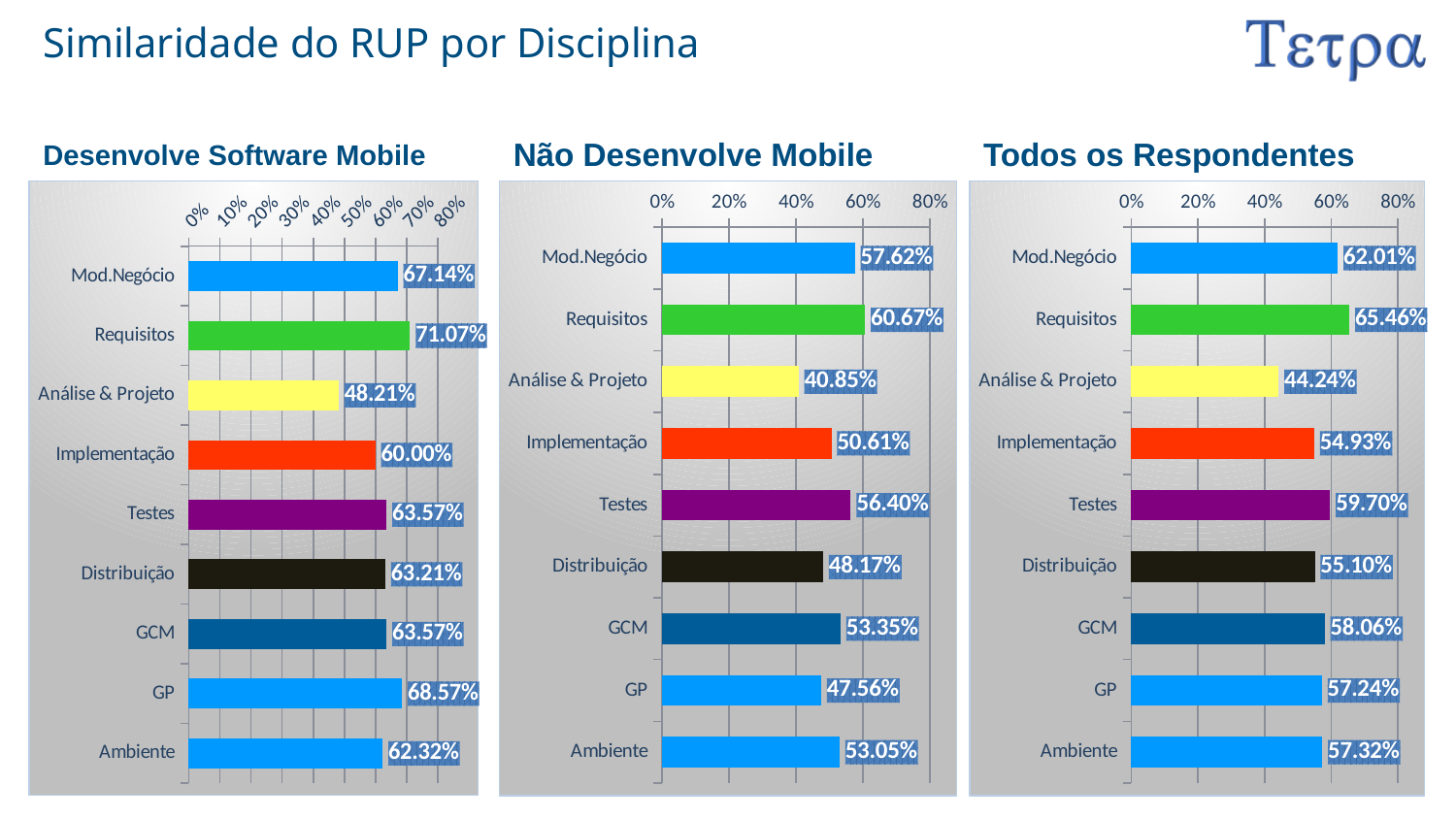
In the 'Desenvolve Software Mobile' chart, what is the difference between Requisitos and Análise & Projeto? 22.86% In the 'Desenvolve Software Mobile' chart, which discipline has the lowest value? Análise & Projeto In the 'Desenvolve Software Mobile' chart, what is the value for Requisitos? 71.07% In the 'Não Desenvolve Mobile' chart, is the value for Análise & Projeto greater or less than 60%? less In the 'Não Desenvolve Mobile' chart, which discipline has the highest value? Requisitos In the 'Não Desenvolve Mobile' chart, what is the value for Implementação? 50.61% In the 'Todos os Respondentes' chart, which is larger, Mod.Negócio or Testes? Mod.Negócio In the 'Todos os Respondentes' chart, which discipline has the lowest value? Análise & Projeto In the 'Todos os Respondentes' chart, what is the value for GCM? 58.06% How many disciplines are shown in the 'Não Desenvolve Mobile' chart? 9 What is the title of the chart on the left of the slide? Desenvolve Software Mobile What kind of chart is the 'Todos os Respondentes' chart? Bar chart